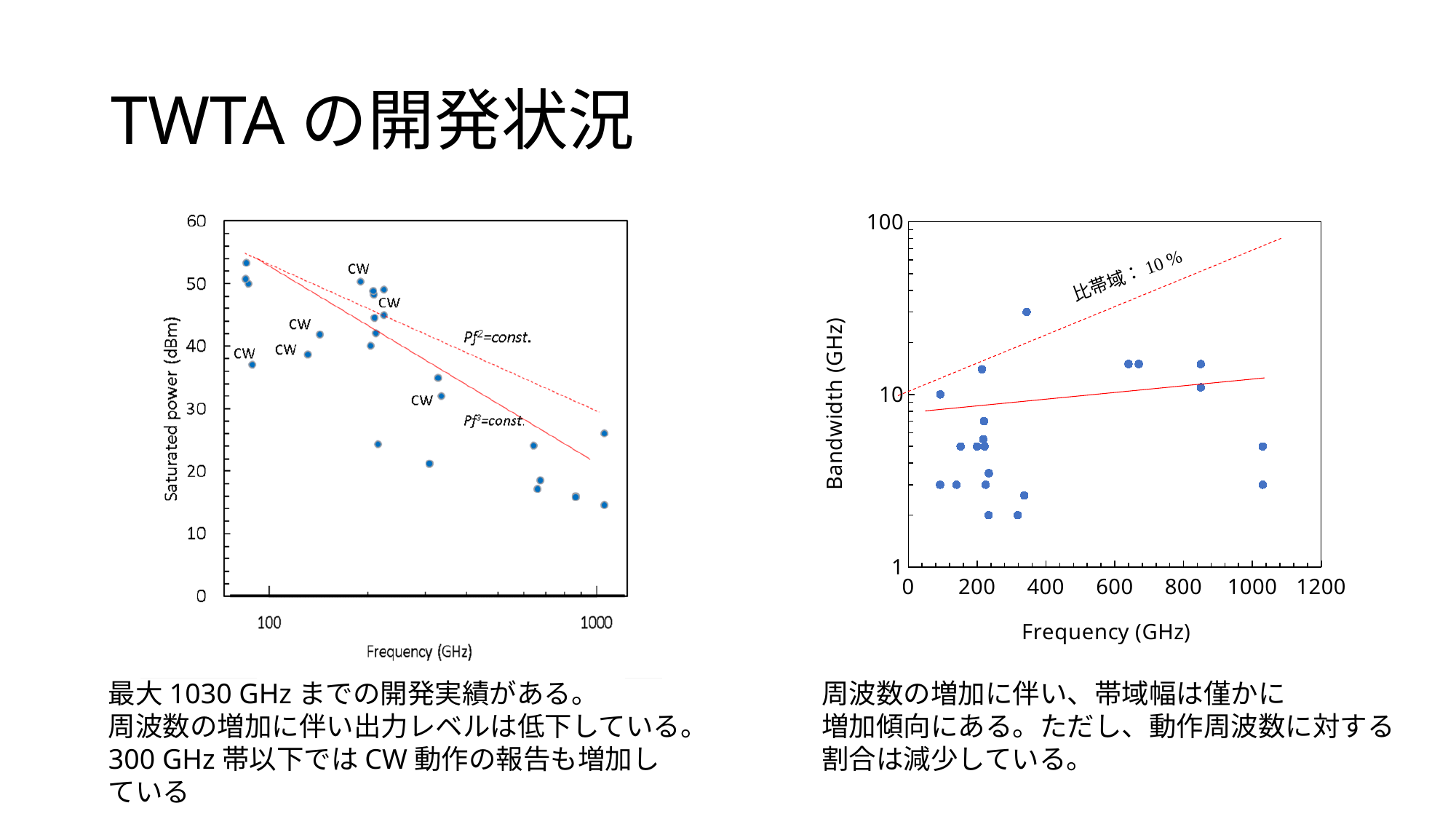
In the left chart, is the saturated power of the points plotted near 1000 GHz greater or less than 30 dBm? Less In the left chart, do the saturated power values generally rise or fall as frequency increases? Fall In the right chart, are the bandwidths of the points plotted near 1030 GHz greater or less than 10 GHz? Less What is the y-axis label of the left chart? Saturated power (dBm) In the left chart, is the highest saturated power plotted near 100 GHz greater or less than 50 dBm? Greater What label is written along the dashed red line in the right chart? 比帯域：10 % What kind of chart is the left chart (Saturated power vs Frequency)? Scatter chart What kind of chart is the right chart (Bandwidth vs Frequency)? Scatter chart In the right chart, does the solid red fitted line rise or fall as frequency increases? Rise